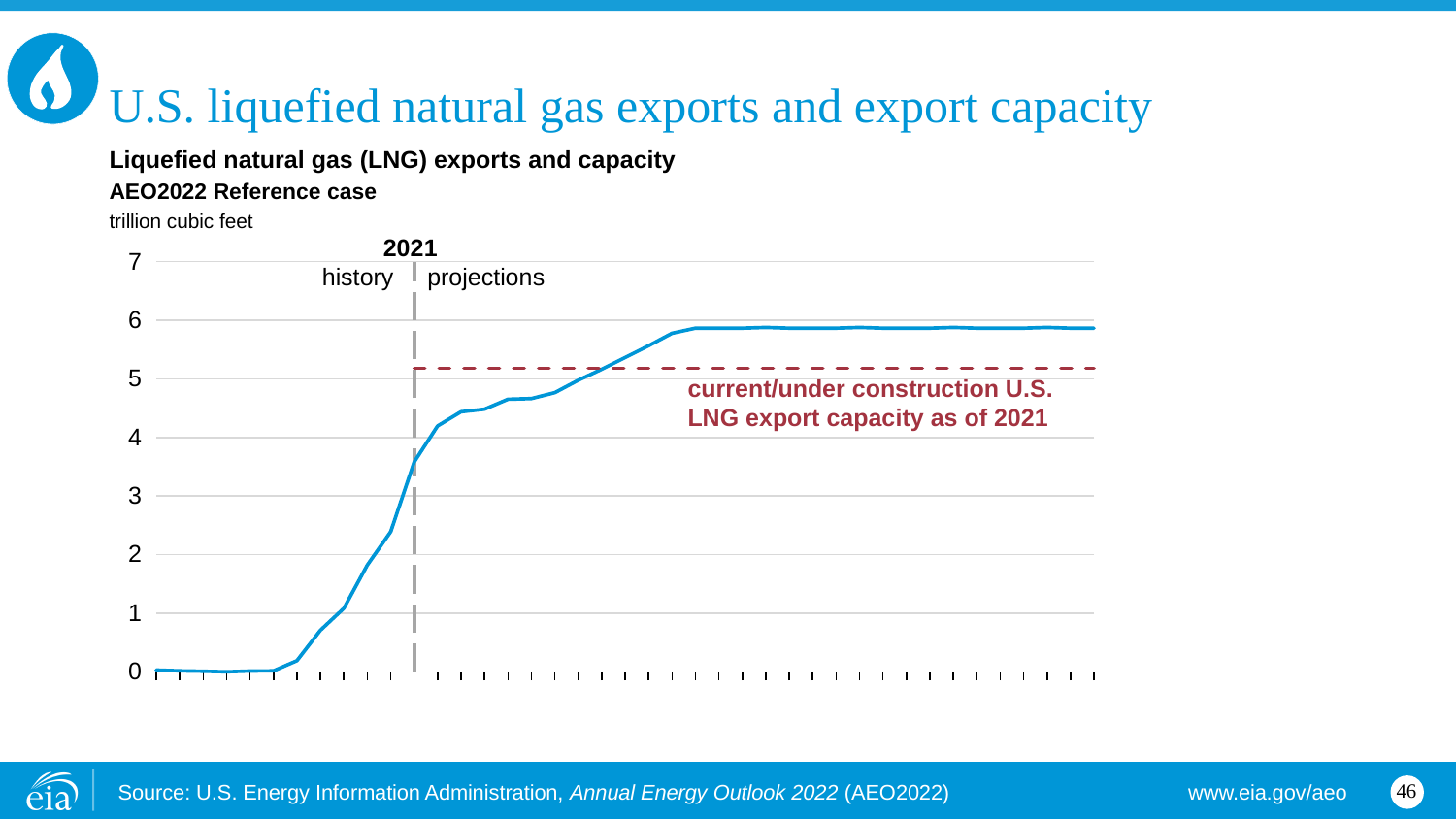
Is the projected plateau of LNG exports higher or lower than the dashed capacity line? higher Do LNG exports rise or fall over the history period of the chart? rise What is the highest value shown on the y axis of the chart? 7 What unit is used on the y axis of the chart? trillion cubic feet Is the current/under construction U.S. LNG export capacity as of 2021 (dashed line) greater or less than 5 trillion cubic feet? greater Which year separates history from projections on the chart? 2021 What kind of chart is shown on the slide? line chart Is the level at which projected LNG exports plateau greater or less than 6 trillion cubic feet? less Are LNG exports at the start of the history period greater or less than 1 trillion cubic feet? less